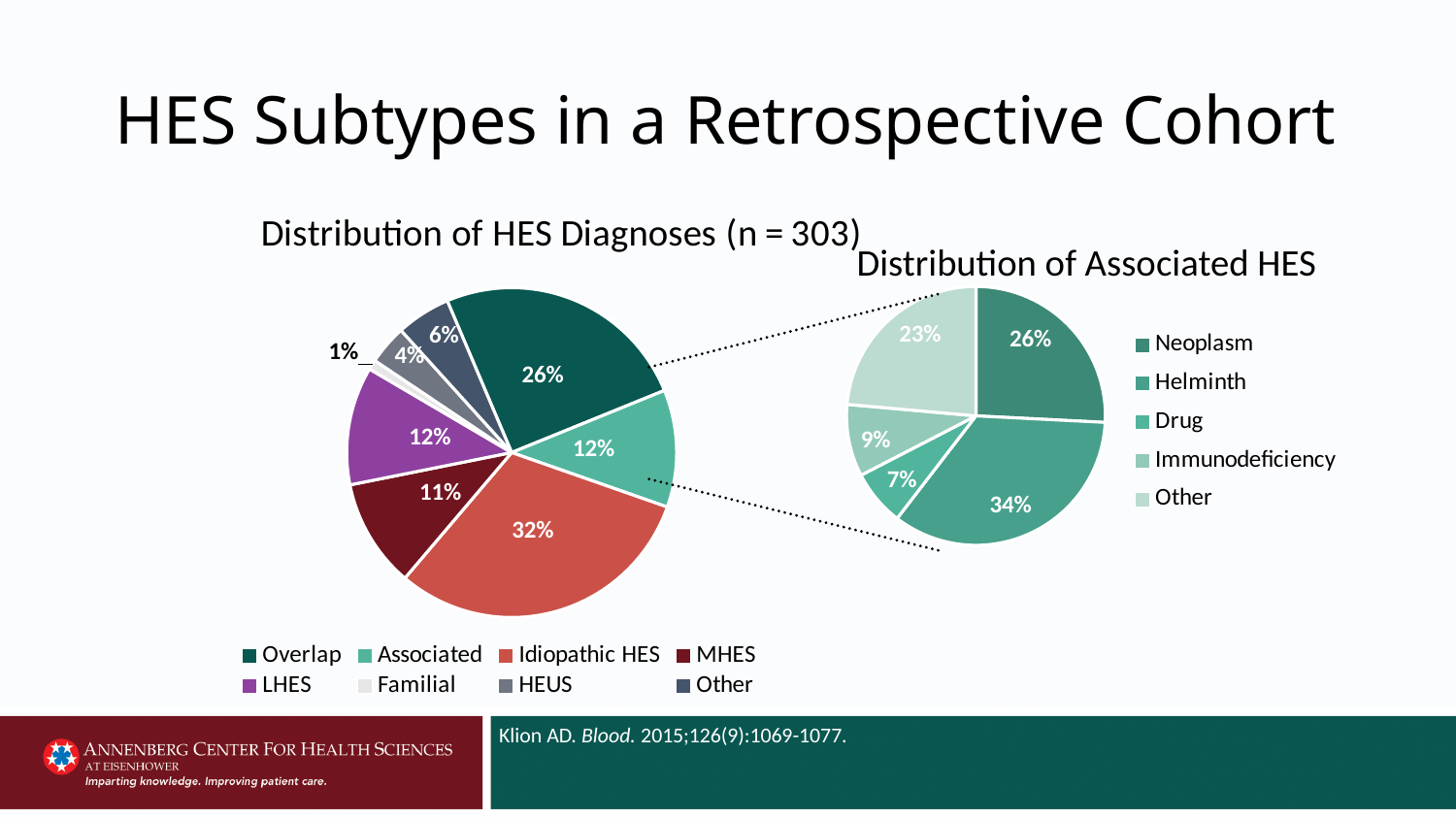
In the 'Distribution of Associated HES' chart, what share is Helminth? 34% In the 'Distribution of Associated HES' chart, which category has the largest share? Helminth In the 'Distribution of HES Diagnoses (n = 303)' chart, how many categories does the legend list? 8 In the 'Distribution of HES Diagnoses (n = 303)' chart, which category has the largest share? Idiopathic HES In the 'Distribution of Associated HES' chart, which is larger, Neoplasm or Other? Neoplasm What type of chart is used for 'Distribution of Associated HES'? Pie chart In the 'Distribution of HES Diagnoses (n = 303)' chart, what share is Overlap? 26% In the 'Distribution of HES Diagnoses (n = 303)' chart, what share is Idiopathic HES? 32% In the 'Distribution of Associated HES' chart, how many categories does the legend list? 5 In the 'Distribution of HES Diagnoses (n = 303)' chart, which category has the smallest share? Familial In the 'Distribution of Associated HES' chart, what share is Drug? 7% In the 'Distribution of HES Diagnoses (n = 303)' chart, what is the difference between the Idiopathic HES share and the Overlap share? 6%